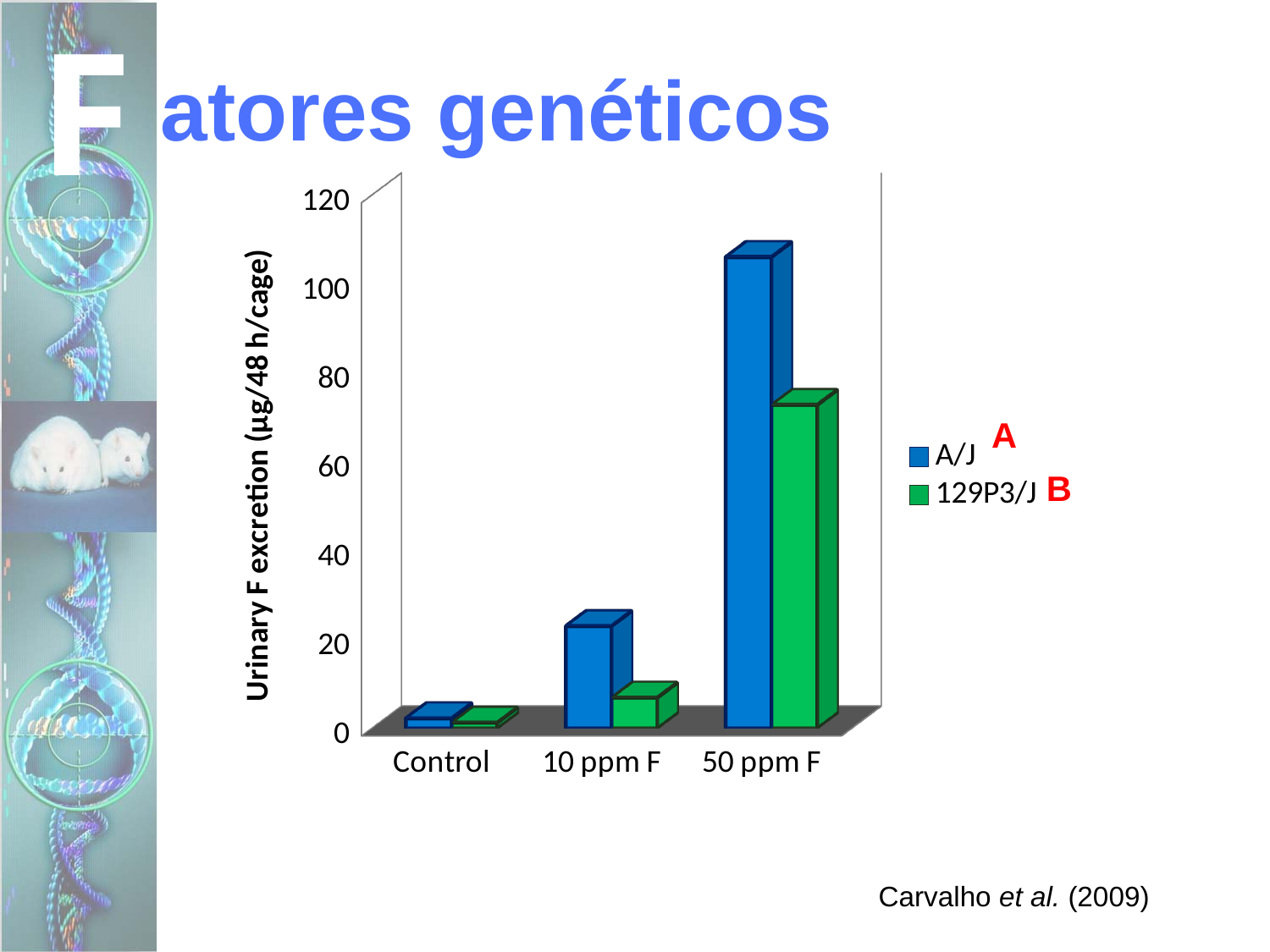
Which category has the lowest urinary F excretion for the 129P3/J series? Control What kind of chart is shown on the slide? bar chart Is the value for 129P3/J at 50 ppm F greater or less than 60? greater At 10 ppm F, which series has the larger urinary F excretion, A/J or 129P3/J? A/J At 50 ppm F, which series has the larger urinary F excretion, A/J or 129P3/J? A/J Is the value for A/J at 50 ppm F greater or less than 80? greater Is the value for 129P3/J at 10 ppm F greater or less than 20? less How many categories are shown on the x axis of the chart? 3 Which category has the highest urinary F excretion for the A/J series? 50 ppm F What is the label of the y axis of the chart? Urinary F excretion (µg/48 h/cage) How many series does the chart's legend list? 2 Do the A/J values rise or fall from Control to 50 ppm F? rise